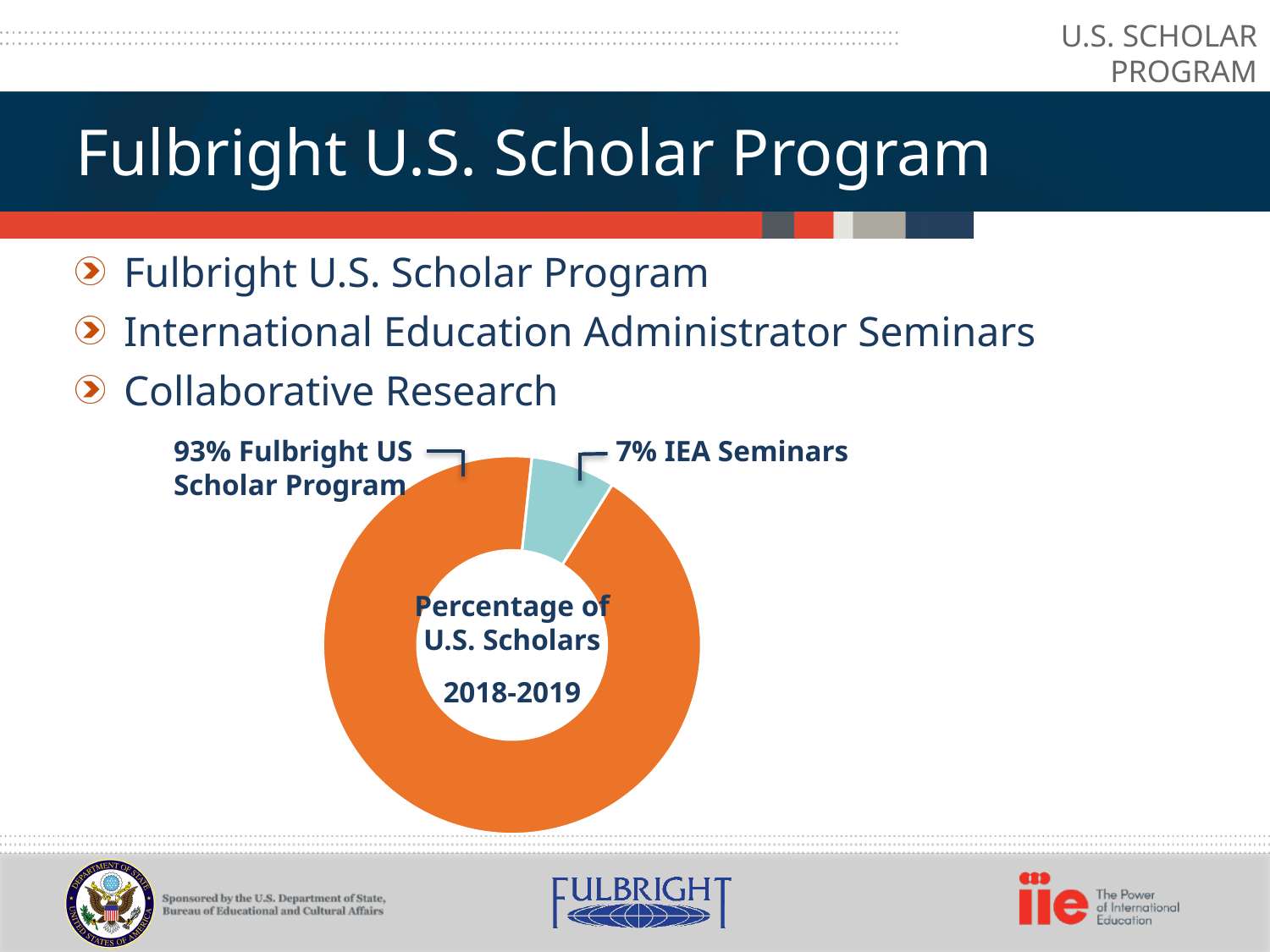
Which segment of the chart is the smallest? IEA Seminars What is the title shown in the center of the chart? Percentage of U.S. Scholars 2018-2019 Which segment of the chart is the largest? Fulbright US Scholar Program What is the total of the two percentages shown in the chart? 100% What colour is the IEA Seminars segment of the chart? Light blue What kind of chart is shown on the slide? Doughnut (pie) chart Which is larger: the Fulbright US Scholar Program share or the IEA Seminars share? Fulbright US Scholar Program What percentage of U.S. Scholars does the Fulbright US Scholar Program account for in the chart? 93% What percentage of U.S. Scholars does IEA Seminars account for in the chart? 7% How many segments does the chart have? 2 What is the difference in percentage points between the Fulbright US Scholar Program and IEA Seminars segments? 86